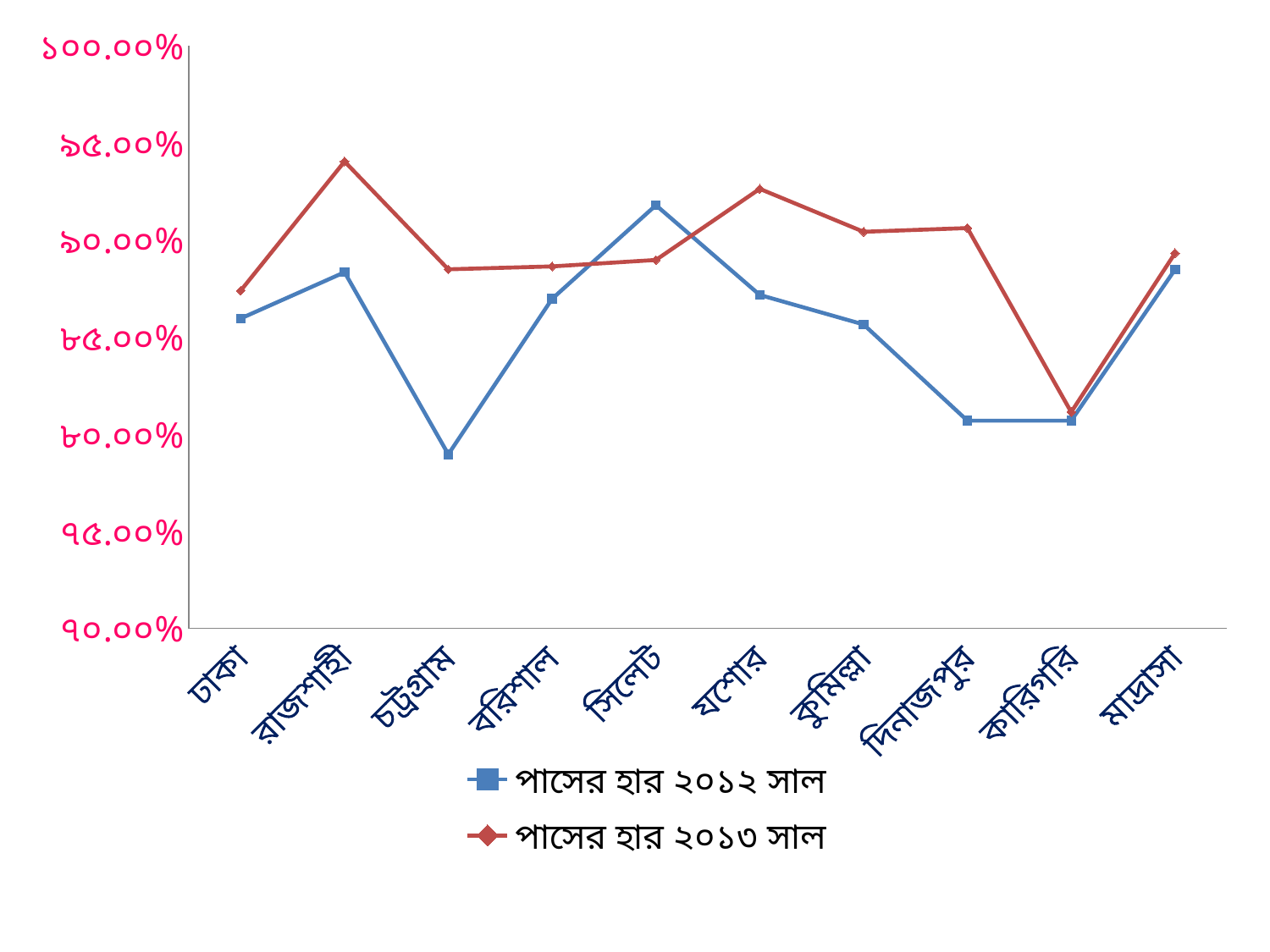
For রাজশাহী, which series has the larger value, পাসের হার ২০১২ সাল or পাসের হার ২০১৩ সাল? পাসের হার ২০১৩ সাল Is the value for সিলেট in পাসের হার ২০১২ সাল greater or less than ৯০.০০%? greater Which category has the highest value for পাসের হার ২০১২ সাল? সিলেট Which category has the lowest value for পাসের হার ২০১২ সাল? চট্টগ্রাম Which category has the highest value for পাসের হার ২০১৩ সাল? রাজশাহী For সিলেট, which series has the larger value, পাসের হার ২০১২ সাল or পাসের হার ২০১৩ সাল? পাসের হার ২০১২ সাল Is the value for চট্টগ্রাম in পাসের হার ২০১২ সাল greater or less than ৮০.০০%? less Is the value for রাজশাহী in পাসের হার ২০১৩ সাল greater or less than ৯০.০০%? greater How many series does the legend list? 2 How many categories are shown along the x axis? 10 What kind of chart is shown on the slide? line chart Which category has the lowest value for পাসের হার ২০১৩ সাল? কারিগরি